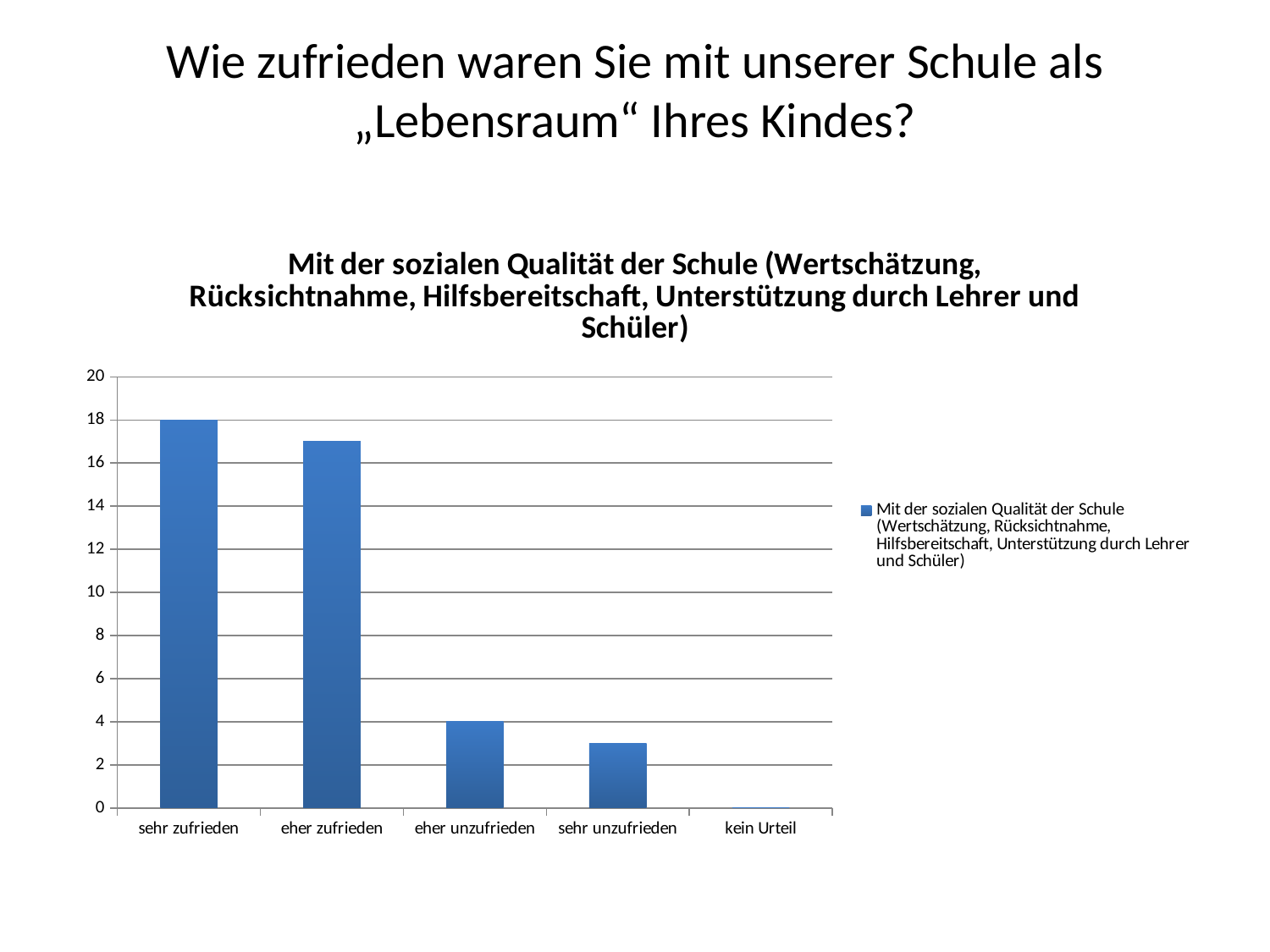
Is the value for "eher zufrieden" greater or less than 16? greater What is the difference between the values for "sehr zufrieden" and "eher unzufrieden"? 14 Is the value for "sehr unzufrieden" greater or less than 4? less How many series does the legend list? 1 Which category has the highest value? sehr zufrieden What is the value for "sehr zufrieden"? 18 What is the value for "kein Urteil"? 0 How many categories are shown on the x axis of the chart? 5 Which is larger, the value for "eher zufrieden" or the value for "eher unzufrieden"? eher zufrieden What type of chart is shown on the slide? bar chart Which category has the lowest value? kein Urteil What is the value for "eher unzufrieden"? 4